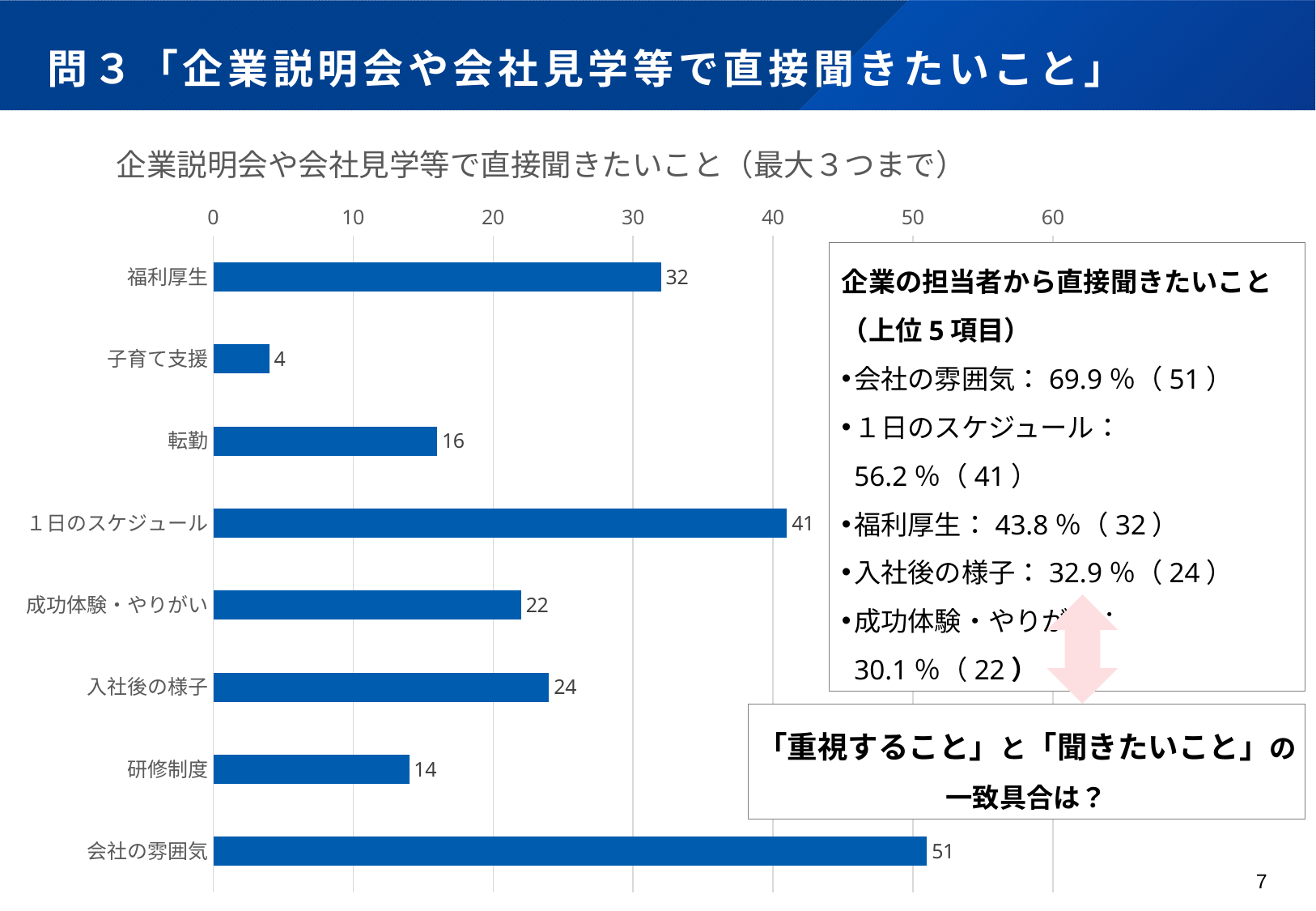
What is the title of the chart? 企業説明会や会社見学等で直接聞きたいこと（最大３つまで） What is the value for 福利厚生? 32 How many categories are shown in the chart? 8 Is the value for １日のスケジュール greater or less than 40? greater What is the value for 子育て支援? 4 Which category has the lowest value? 子育て支援 Which is larger, the value for 入社後の様子 or the value for 成功体験・やりがい? 入社後の様子 What is the difference between the values for 会社の雰囲気 and １日のスケジュール? 10 What kind of chart is shown on the slide? bar chart Which category has the highest value? 会社の雰囲気 What is the value for 転勤? 16 What is the value for 研修制度? 14